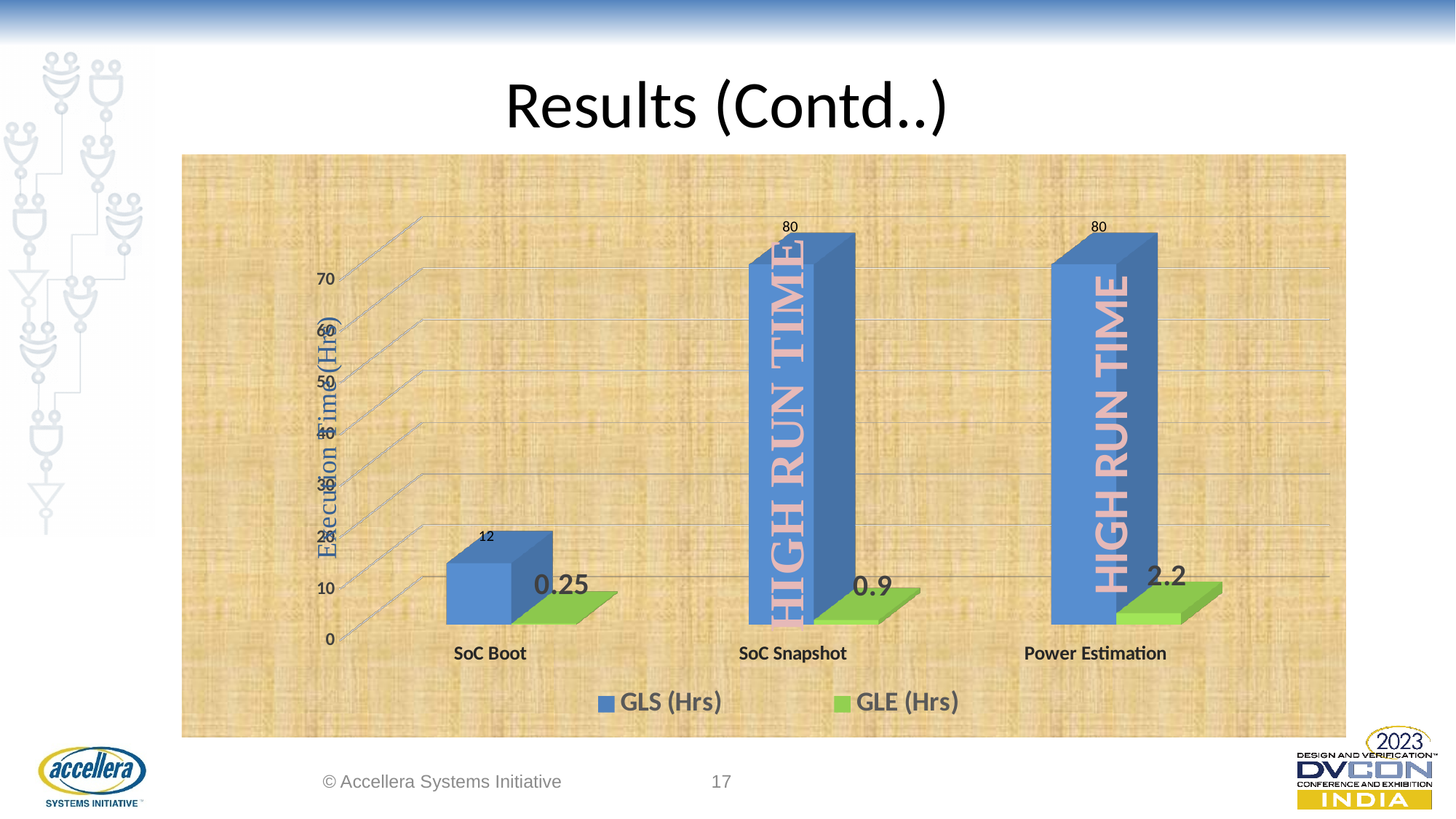
What is the label of the vertical axis? Execution Time (Hrs) What is the GLE (Hrs) value for SoC Snapshot? 0.9 Which category has the highest GLE (Hrs) value? Power Estimation How many categories are shown on the x axis? 3 What is the GLS (Hrs) value for Power Estimation? 80 What is the GLS (Hrs) value for SoC Boot? 12 What kind of chart is shown on the slide? Bar chart What is the GLE (Hrs) value for Power Estimation? 2.2 How many series does the legend list? 2 Which is larger, the GLE (Hrs) value for SoC Boot or for SoC Snapshot? SoC Snapshot What is the difference between the GLS (Hrs) values for SoC Snapshot and SoC Boot? 68 Which category has the lowest GLS (Hrs) value? SoC Boot